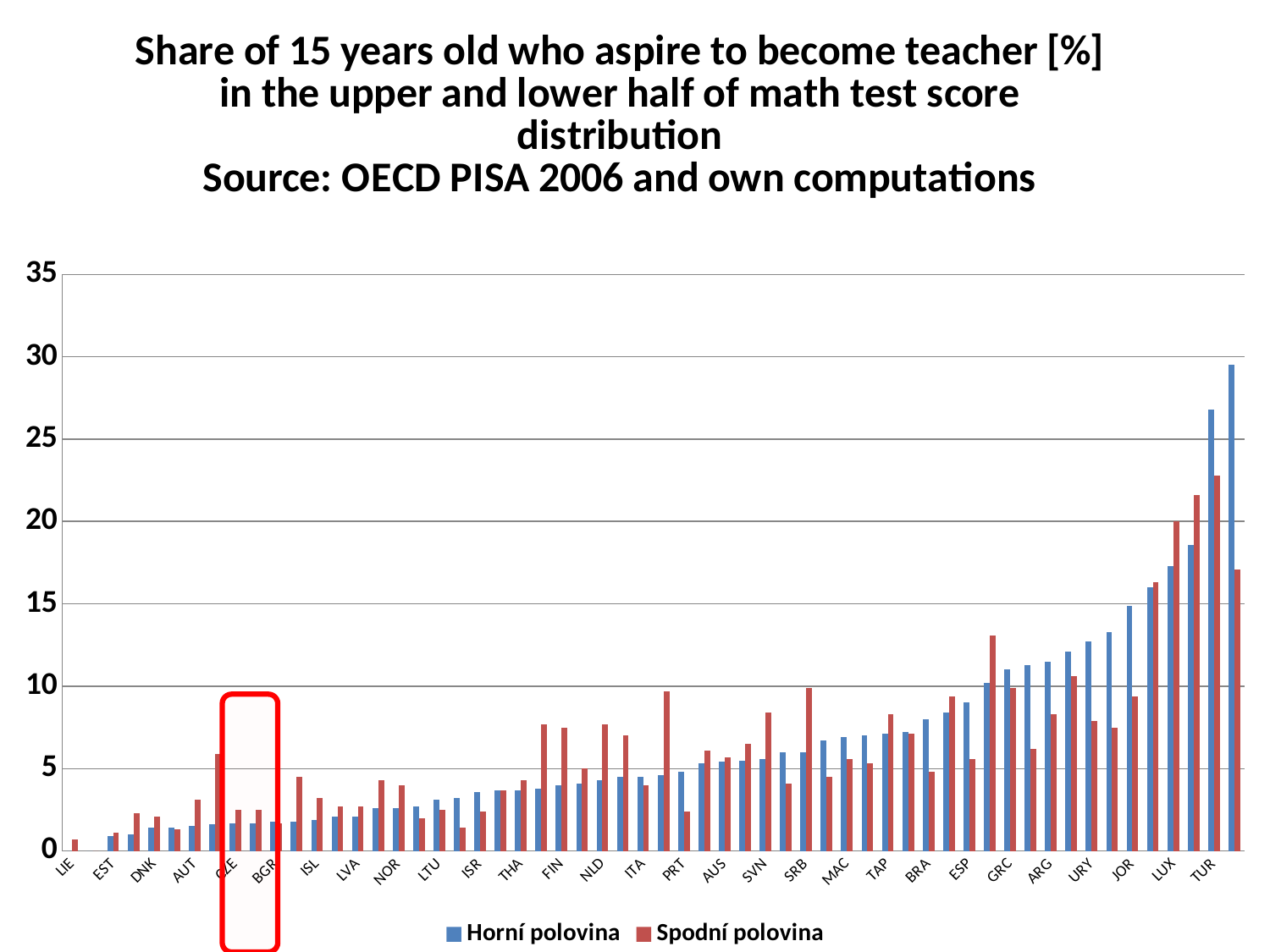
What are the two series named in the legend? Horní polovina and Spodní polovina Which colour represents the Spodní polovina series? red Is the Horní polovina value for TUR greater or less than 25? greater For GRC, which series has the larger value, Horní polovina or Spodní polovina? Horní polovina Is the Spodní polovina value for FIN greater or less than 5? greater Do the Horní polovina values generally rise or fall from left to right along the x axis? rise How many series does the legend list? 2 Is the Spodní polovina value for JOR greater or less than 10? less For TUR, which series has the larger value, Horní polovina or Spodní polovina? Horní polovina What kind of chart is shown on the slide? bar chart